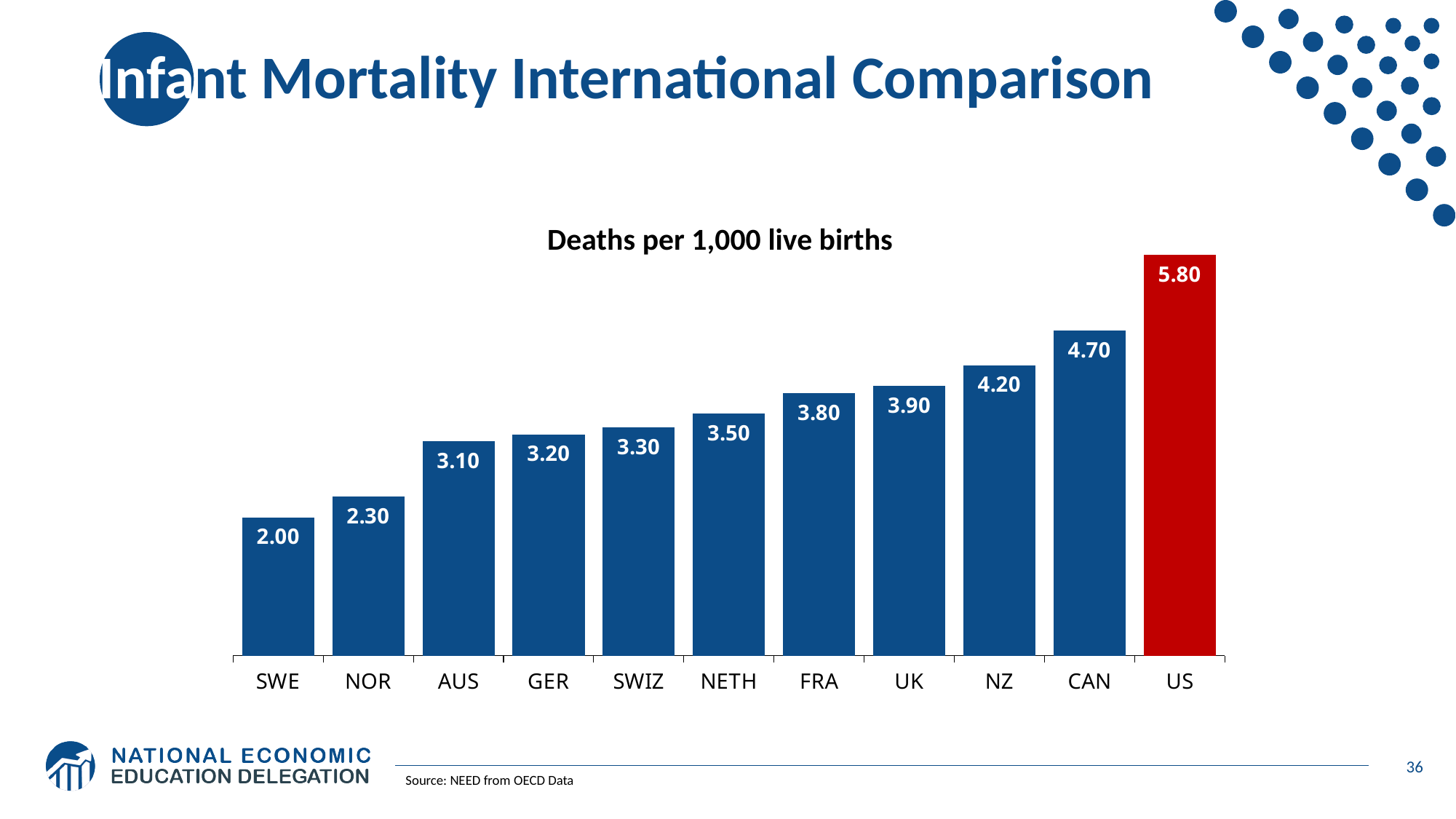
How many countries are shown in the chart? 11 What is the value for the US? 5.80 Which country has the lowest value? SWE What is the value for NZ? 4.20 Which bar is coloured red rather than blue? US Which is larger, the value for NETH or the value for NOR? NETH What is the value for GER? 3.20 What kind of chart is this? Bar chart What is the difference between the values for FRA and SWE? 1.80 Do the values rise or fall from left to right along the x axis? Rise Which country has the highest value? US What is the difference between the values for the US and CAN? 1.10